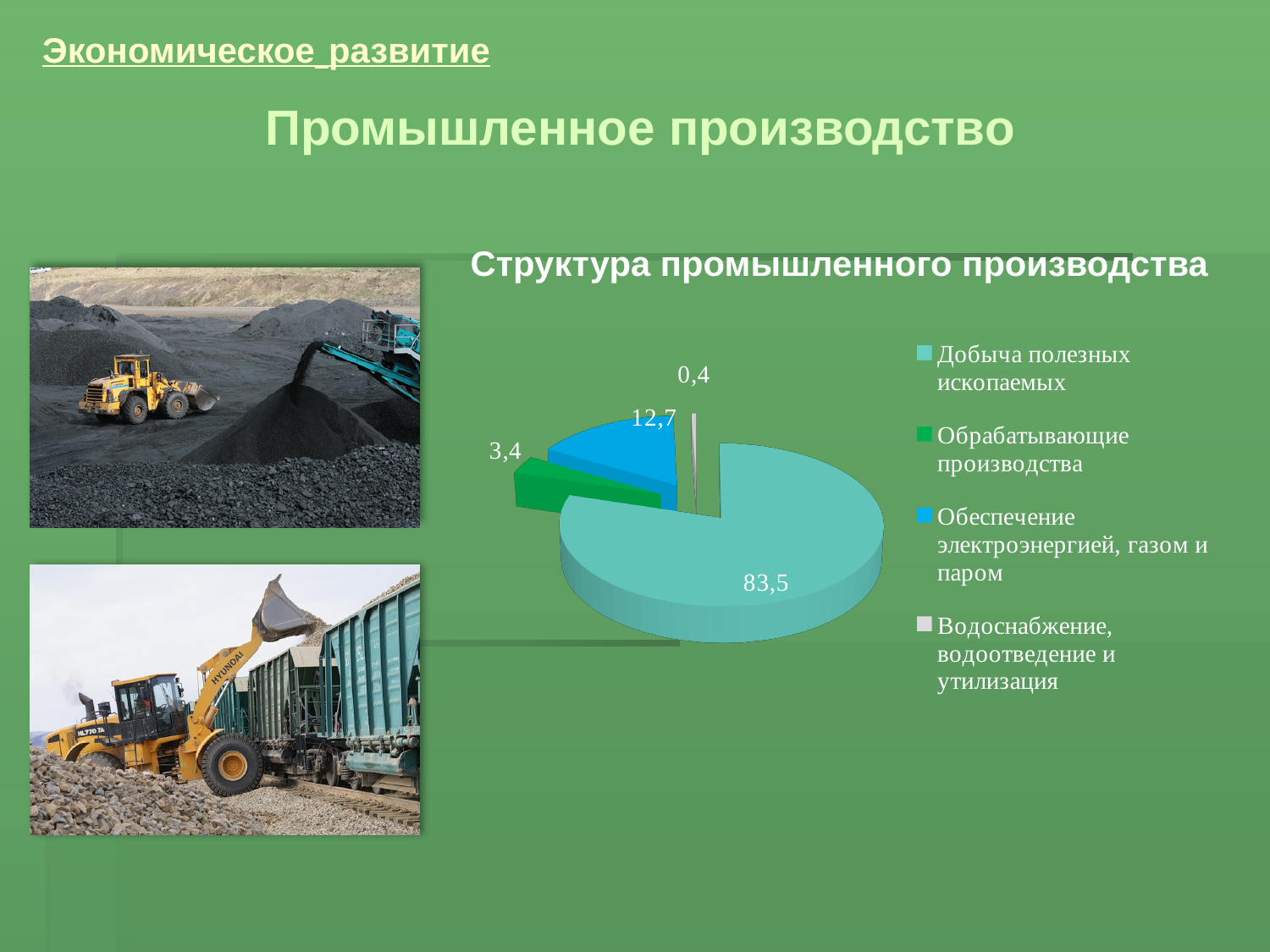
What is the title of the pie chart? Структура промышленного производства How many categories does the legend of the pie chart list? 4 What is the value for "Обеспечение электроэнергией, газом и паром" in the pie chart? 12,7 What is the value for "Обрабатывающие производства" in the pie chart? 3,4 Which is larger in the pie chart: "Обрабатывающие производства" or "Обеспечение электроэнергией, газом и паром"? Обеспечение электроэнергией, газом и паром Which category has the smallest slice in the pie chart? Водоснабжение, водоотведение и утилизация What is the value for "Водоснабжение, водоотведение и утилизация" in the pie chart? 0,4 Which category has the largest slice in the pie chart? Добыча полезных ископаемых What is the difference between the values for "Обеспечение электроэнергией, газом и паром" and "Обрабатывающие производства"? 9,3 What is the value for "Добыча полезных ископаемых" in the pie chart? 83,5 What kind of chart is shown under the title "Структура промышленного производства"? pie chart What is the difference between the values for "Добыча полезных ископаемых" and "Обеспечение электроэнергией, газом и паром"? 70,8